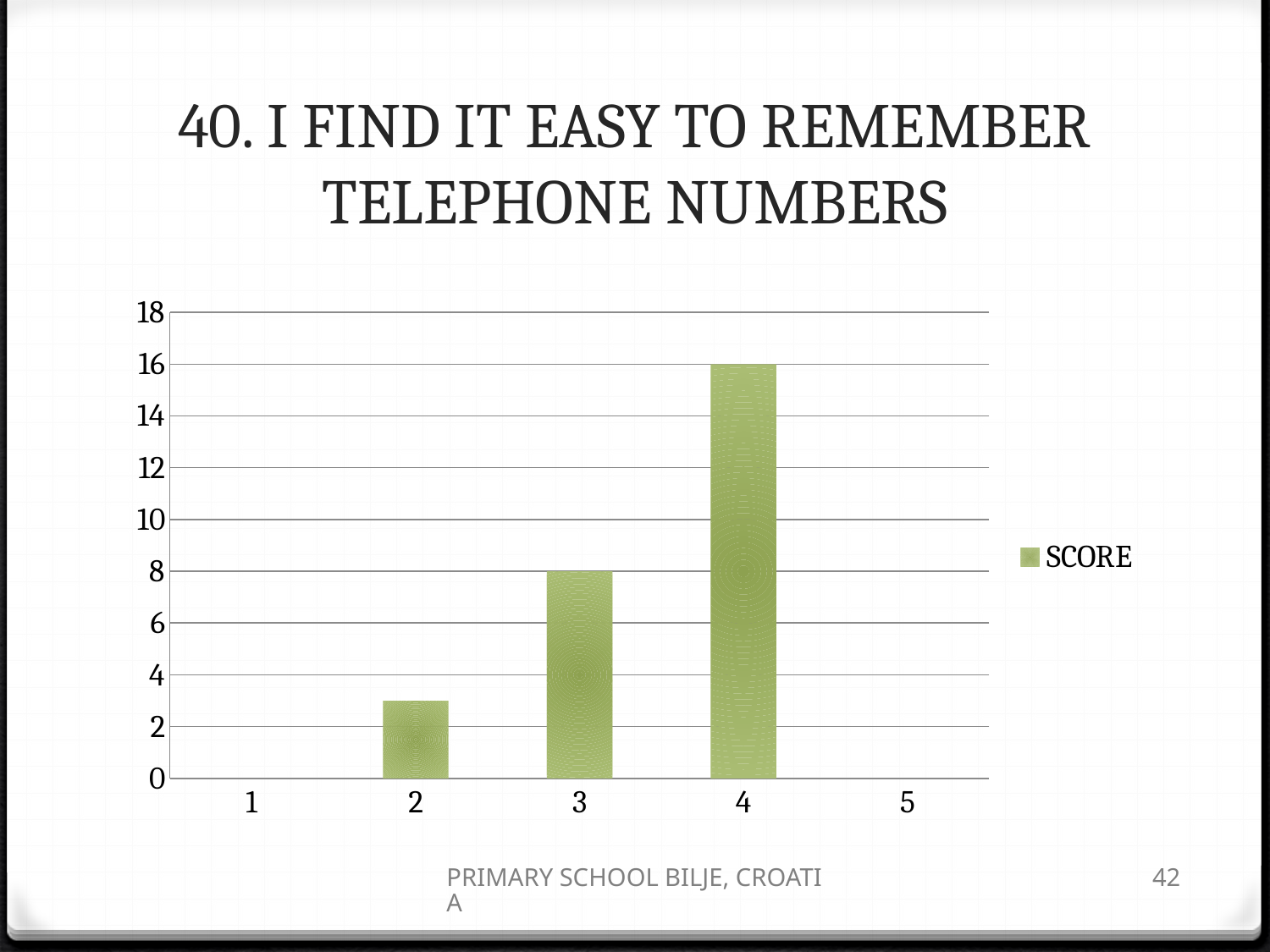
What is the name of the series shown in the legend? SCORE Which category has the larger value, 2 or 3? 3 How many series does the legend list? 1 Is the value for category 4 greater or less than 14? greater What is the difference between the values for category 4 and category 3? 8 How many categories are shown on the x axis? 5 What type of chart is shown on the slide? bar chart What is the value for category 3? 8 Which category has the highest value? 4 Do the values rise or fall from category 2 to category 4? rise What is the value for category 4? 16 Is the value for category 2 greater or less than 4? less